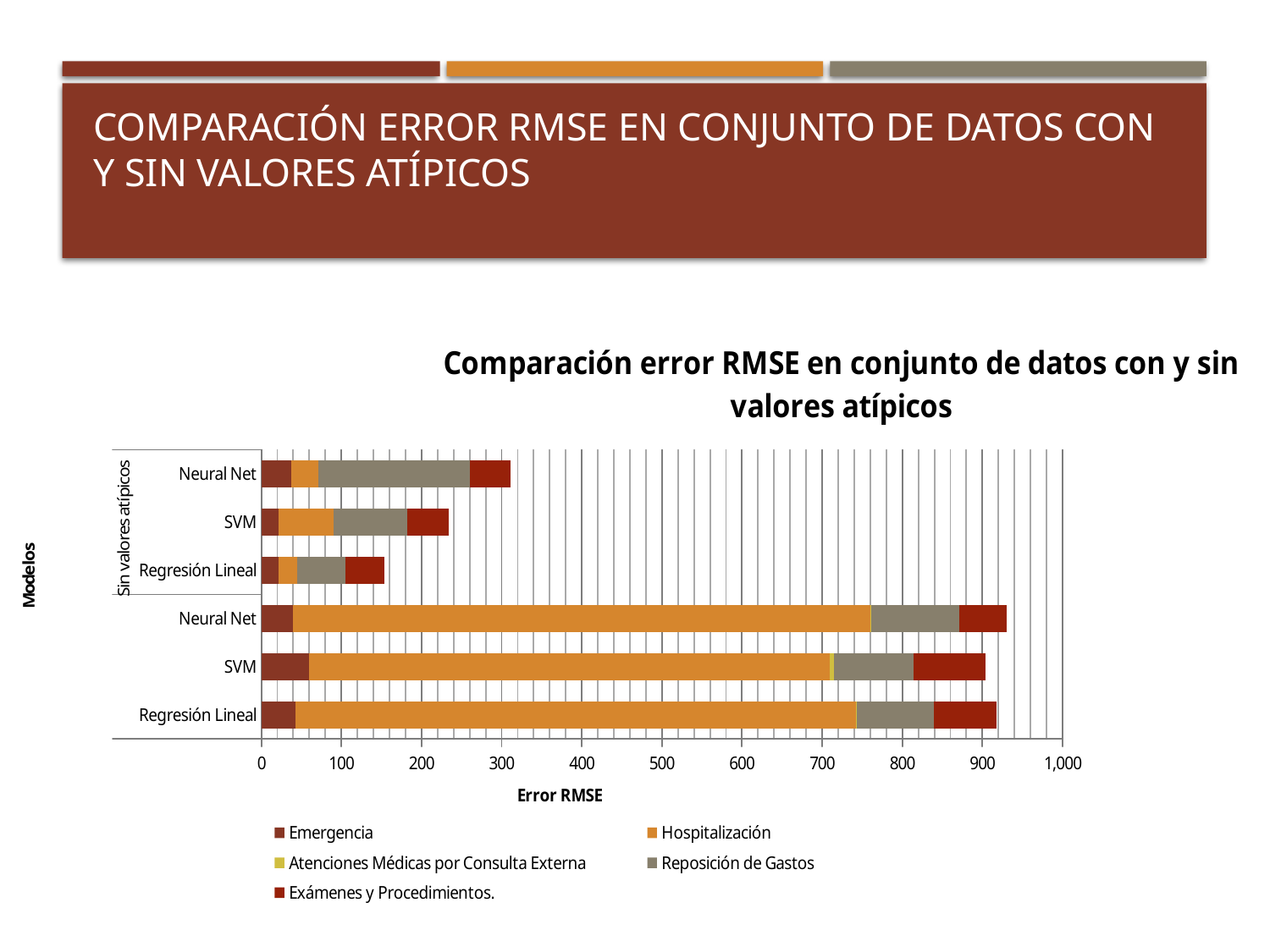
What is the label of the horizontal axis? Error RMSE Is the total value of the bottom Neural Net bar (the group without the 'Sin valores atípicos' label) greater or less than 900? greater What is the label of the vertical axis? Modelos Is the total value of the SVM bar in the 'Sin valores atípicos' group greater or less than 300? less What type of chart is shown on the slide? Stacked bar chart Which bar has the smallest total value in the chart? Regresión Lineal (Sin valores atípicos) Is the total value of the Neural Net bar in the 'Sin valores atípicos' group greater or less than 200? greater How many bars are plotted in the chart? 6 Within the 'Sin valores atípicos' group, which bar has the larger total value, Neural Net or SVM? Neural Net How many series does the legend list? 5